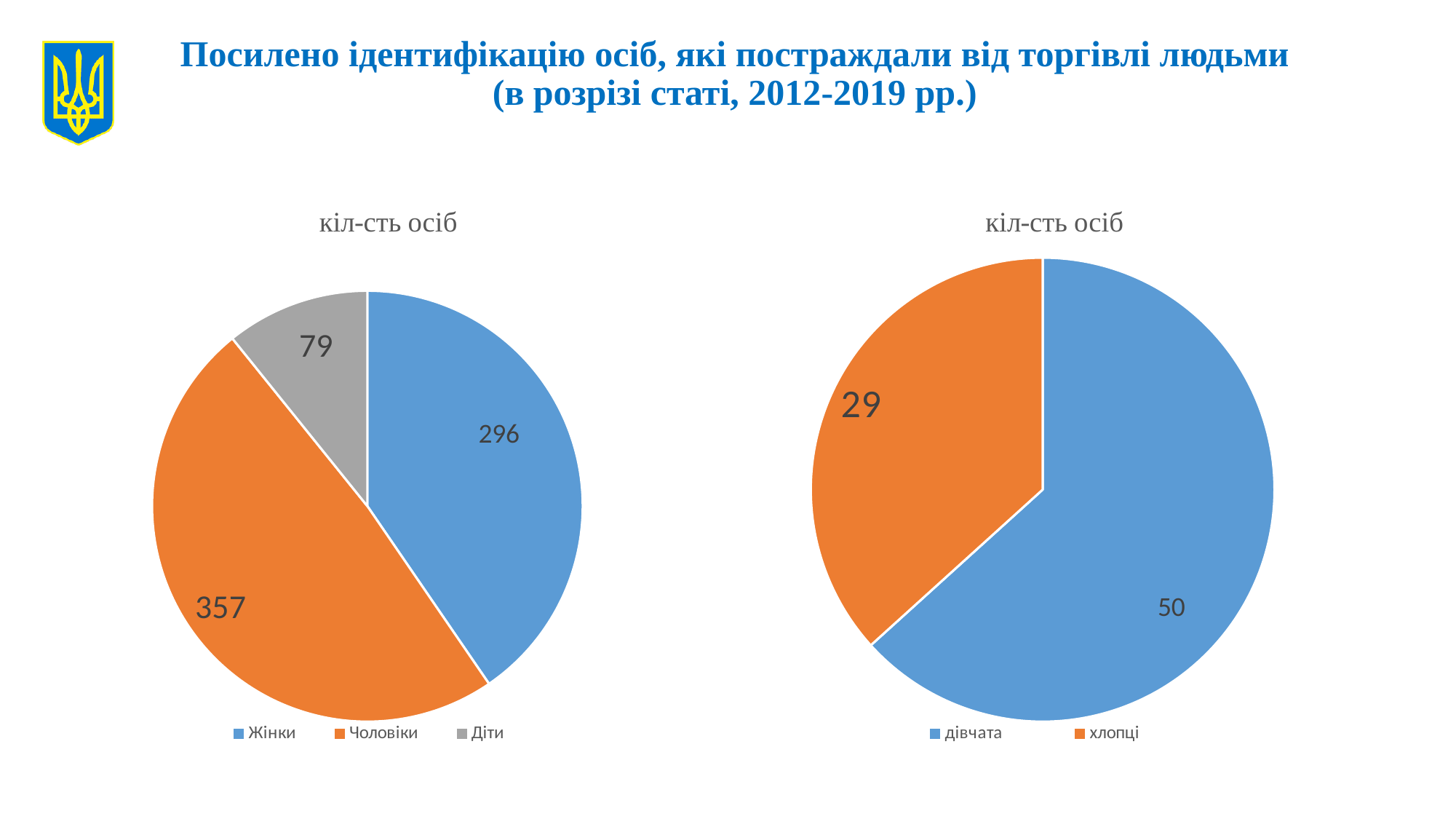
In the left pie chart, which category has the largest value? Чоловіки In the right pie chart, what is the value for хлопці? 29 What type of chart is the right chart? Pie chart In the right pie chart, what is the value for дівчата? 50 In the right pie chart, which is larger, дівчата or хлопці? дівчата In the left pie chart, what is the difference between the values for Чоловіки and Жінки? 61 How many categories does the left pie chart show? 3 In the left pie chart, what is the value for Діти? 79 In the left pie chart, which category has the smallest value? Діти In the right pie chart, what is the difference between the values for дівчата and хлопці? 21 In the left pie chart, what is the value for Чоловіки? 357 In the left pie chart, what is the value for Жінки? 296